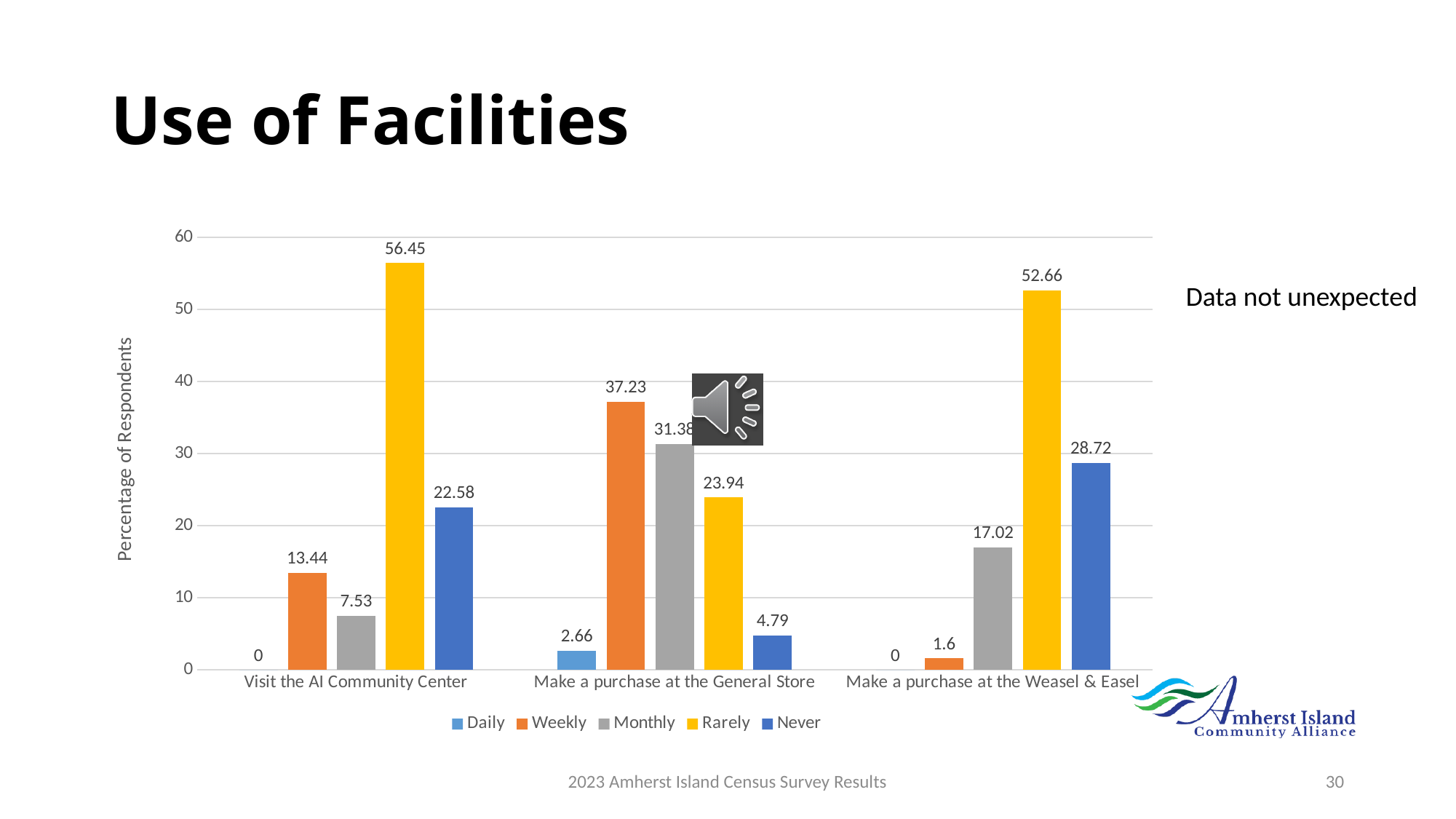
What is the value for Daily in the 'Make a purchase at the General Store' category? 2.66 What is the value for Never in the 'Make a purchase at the Weasel & Easel' category? 28.72 What is the difference between the Rarely values for 'Visit the AI Community Center' and 'Make a purchase at the Weasel & Easel'? 3.79 What percentage of respondents said they rarely visit the AI Community Center? 56.45 How many categories are shown on the x axis? 3 Is the Never value for 'Visit the AI Community Center' greater or less than 20? greater Which is larger: the Monthly value for the General Store or the Monthly value for the Weasel & Easel? Monthly value for the General Store What kind of chart is shown on the slide? Bar chart Which series has the highest value in the 'Make a purchase at the General Store' category? Weekly Which series has the lowest value in the 'Make a purchase at the Weasel & Easel' category? Daily How many series does the legend list? 5 What is the value for Weekly in the 'Make a purchase at the General Store' category? 37.23